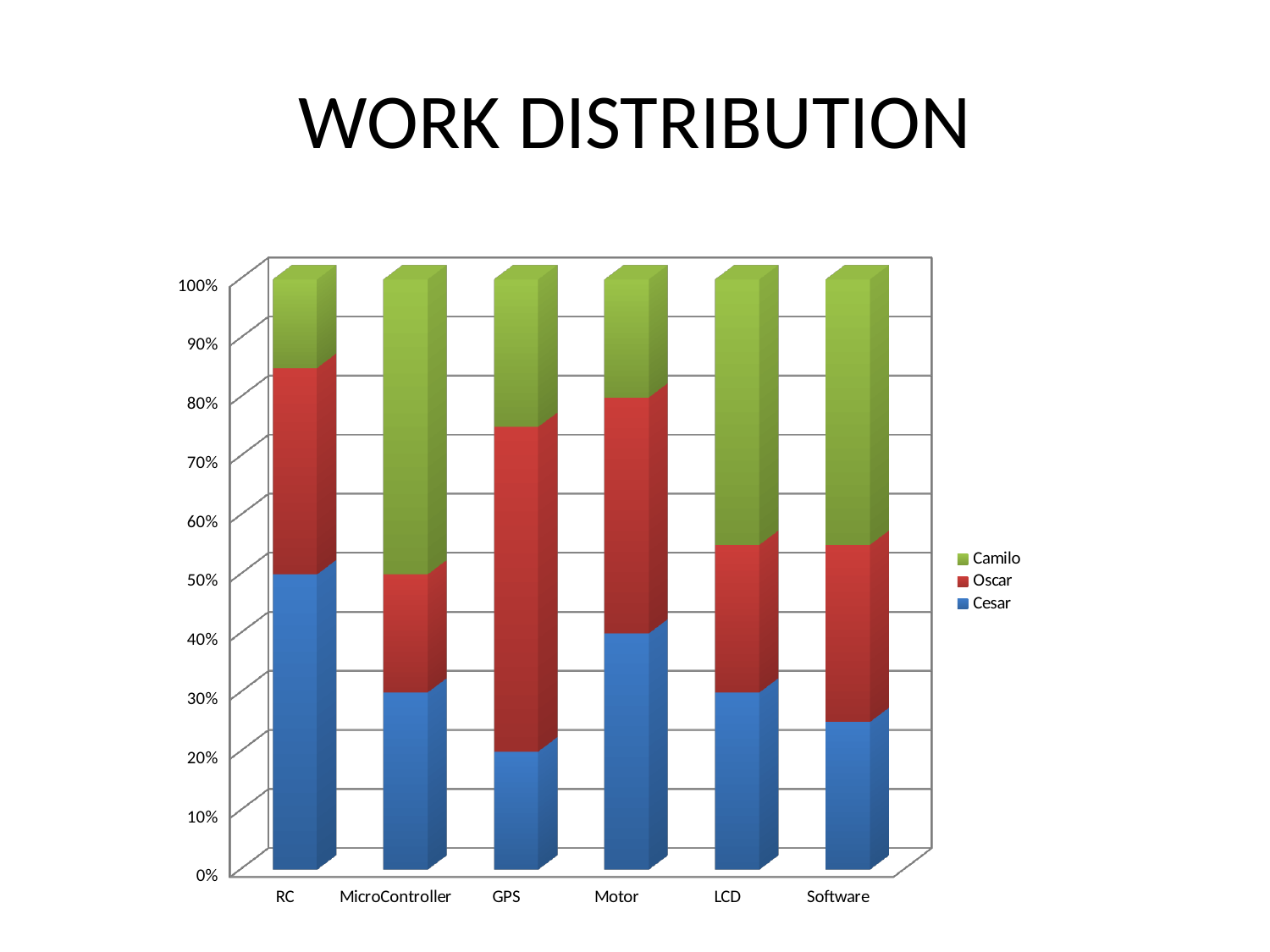
How many series does the legend list? 3 In which category does Camilo have the smallest share? RC Is Oscar's share larger in GPS or in MicroController? GPS Is the value for Cesar in Motor greater or less than 30%? greater In which category does Cesar have the smallest share? GPS How many categories are shown along the x axis? 6 Which colour represents Cesar in the chart? Blue What type of chart is shown on the slide? Stacked bar chart What is the title of the slide? WORK DISTRIBUTION In which category does Cesar have the largest share? RC Is the value for Cesar in RC greater or less than 40%? greater Is the value for Cesar in GPS greater or less than 30%? less